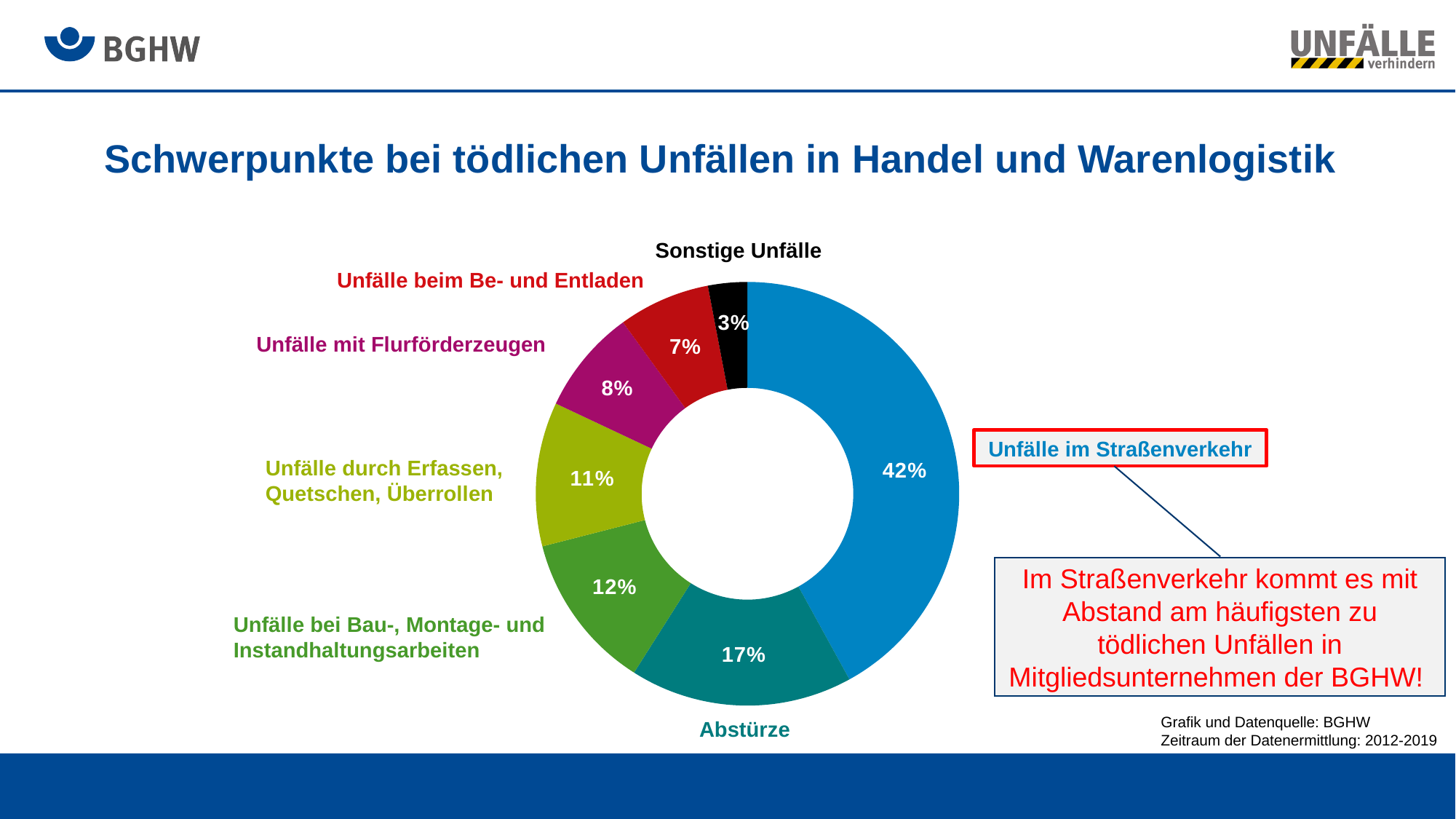
Which is larger: the share for Unfälle bei Bau-, Montage- und Instandhaltungsarbeiten or the share for Unfälle durch Erfassen, Quetschen, Überrollen? Unfälle bei Bau-, Montage- und Instandhaltungsarbeiten What percentage is shown for Abstürze? 17% What percentage is shown for Unfälle mit Flurförderzeugen? 8% Which category has the smallest share of the chart? Sonstige Unfälle What percentage is shown for Unfälle beim Be- und Entladen? 7% What is the combined share of Unfälle mit Flurförderzeugen and Unfälle beim Be- und Entladen? 15% What share of fatal accidents is attributed to Unfälle im Straßenverkehr? 42% Which category has the largest share of the chart? Unfälle im Straßenverkehr What is the difference in percentage points between Unfälle im Straßenverkehr and Abstürze? 25 What is the title of the slide? Schwerpunkte bei tödlichen Unfällen in Handel und Warenlogistik What kind of chart is shown on the slide? Doughnut (pie) chart How many categories are shown in the chart? 7